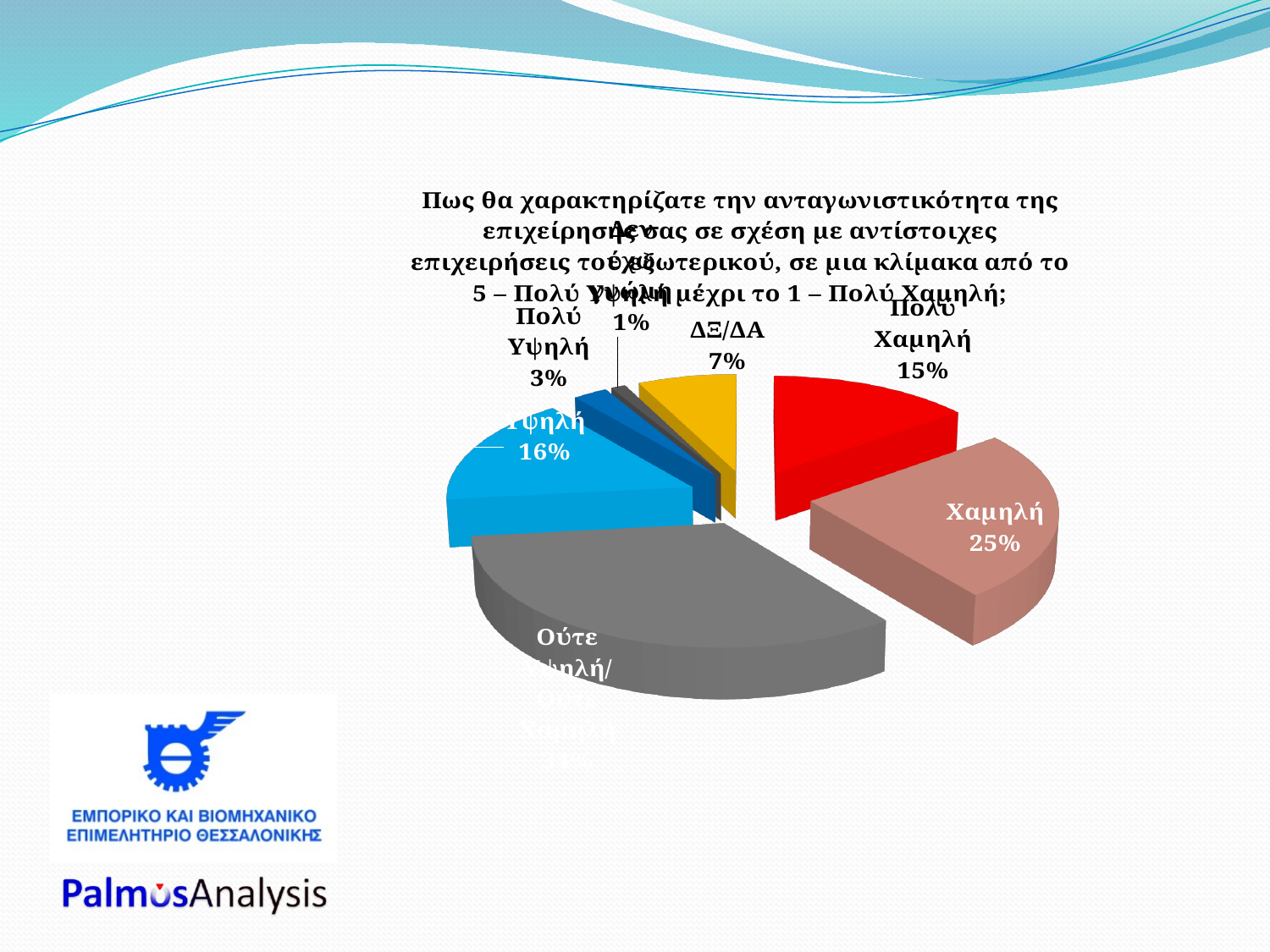
What is the difference in percentage points between the Χαμηλή slice and the Πολύ Χαμηλή slice? 10% What percentage of the pie is labelled Πολύ Υψηλή? 3% What colour is the ΔΞ/ΔΑ slice? Yellow Which slice is larger, ΔΞ/ΔΑ or Πολύ Υψηλή? ΔΞ/ΔΑ Which slice is larger, Υψηλή or Πολύ Χαμηλή? Υψηλή What percentage of the pie is labelled ΔΞ/ΔΑ? 7% What percentage of the pie is labelled Υψηλή? 16% What percentage of the pie is labelled Πολύ Χαμηλή? 15% What kind of chart is shown on the slide? Pie chart What is the difference in percentage points between the Υψηλή slice and the Πολύ Υψηλή slice? 13% What percentage of the pie is labelled Χαμηλή? 25% How many slices does the pie chart have? 7